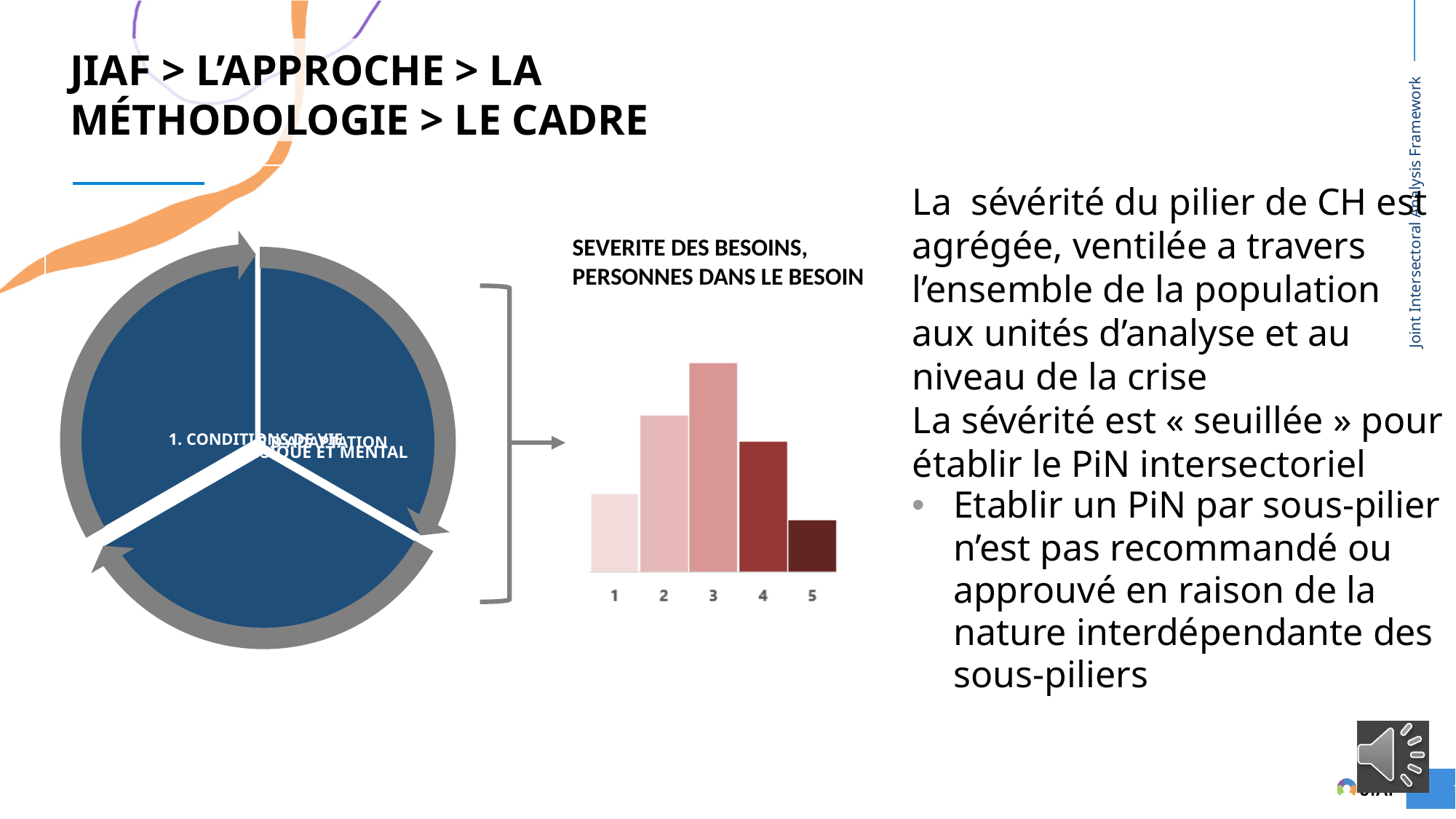
In the bar chart, which bar is taller, category 1 or category 3? 3 In the bar chart, which bar is taller, category 2 or category 4? 2 What kind of chart is shown under the heading "SEVERITE DES BESOINS, PERSONNES DANS LE BESOIN"? bar chart How many bars does the bar chart on the slide have? 5 How does the colour of the bars change from category 1 to category 5? It gets darker, from light pink to dark red Which category has the shortest bar in the bar chart? 5 In the bar chart, which bar is taller, category 1 or category 5? 1 How do the bar heights change from category 1 to category 5 in the bar chart? They rise from 1 to 3, then fall from 3 to 5 What is the heading written above the bar chart? SEVERITE DES BESOINS, PERSONNES DANS LE BESOIN Which category has the tallest bar in the bar chart? 3